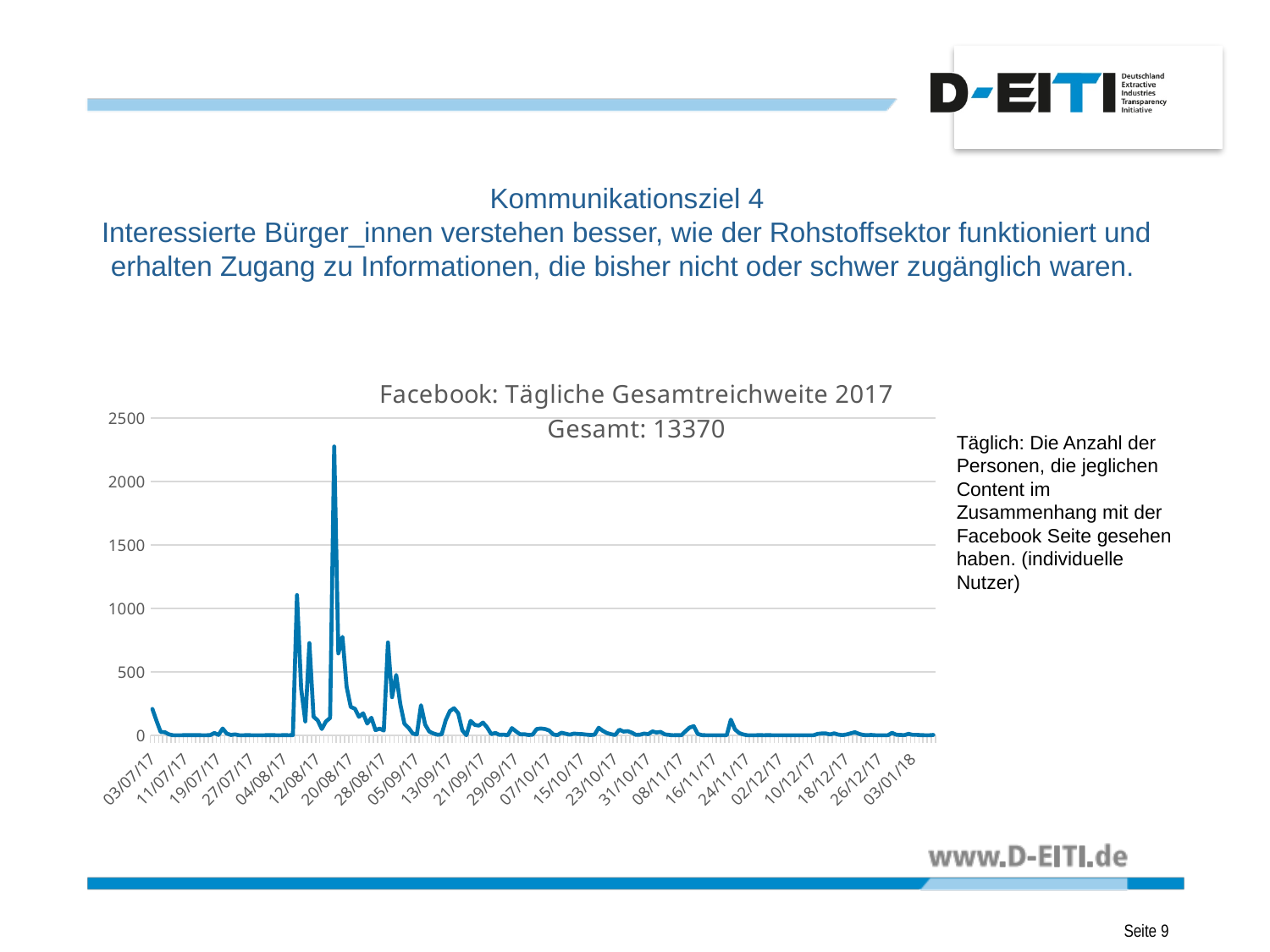
Is the value at the peak near 28/08/17 greater or less than 1000? less Is the value at the end of the series, 03/01/18, greater or less than 500? less How many lines (series) are plotted in the chart? 1 What is the title of the chart? Facebook: Tägliche Gesamtreichweite 2017 Gesamt: 13370 What is the highest value shown on the vertical axis? 2500 In which month does the line reach its highest value? August 2017 Is the value at the start of the series, 03/07/17, greater or less than 500? less What kind of chart is shown on the slide? line chart What total (Gesamt) is stated in the chart title? 13370 After the peak in August 2017, do the values generally rise or fall towards the end of the year? fall What is the first date label on the horizontal axis? 03/07/17